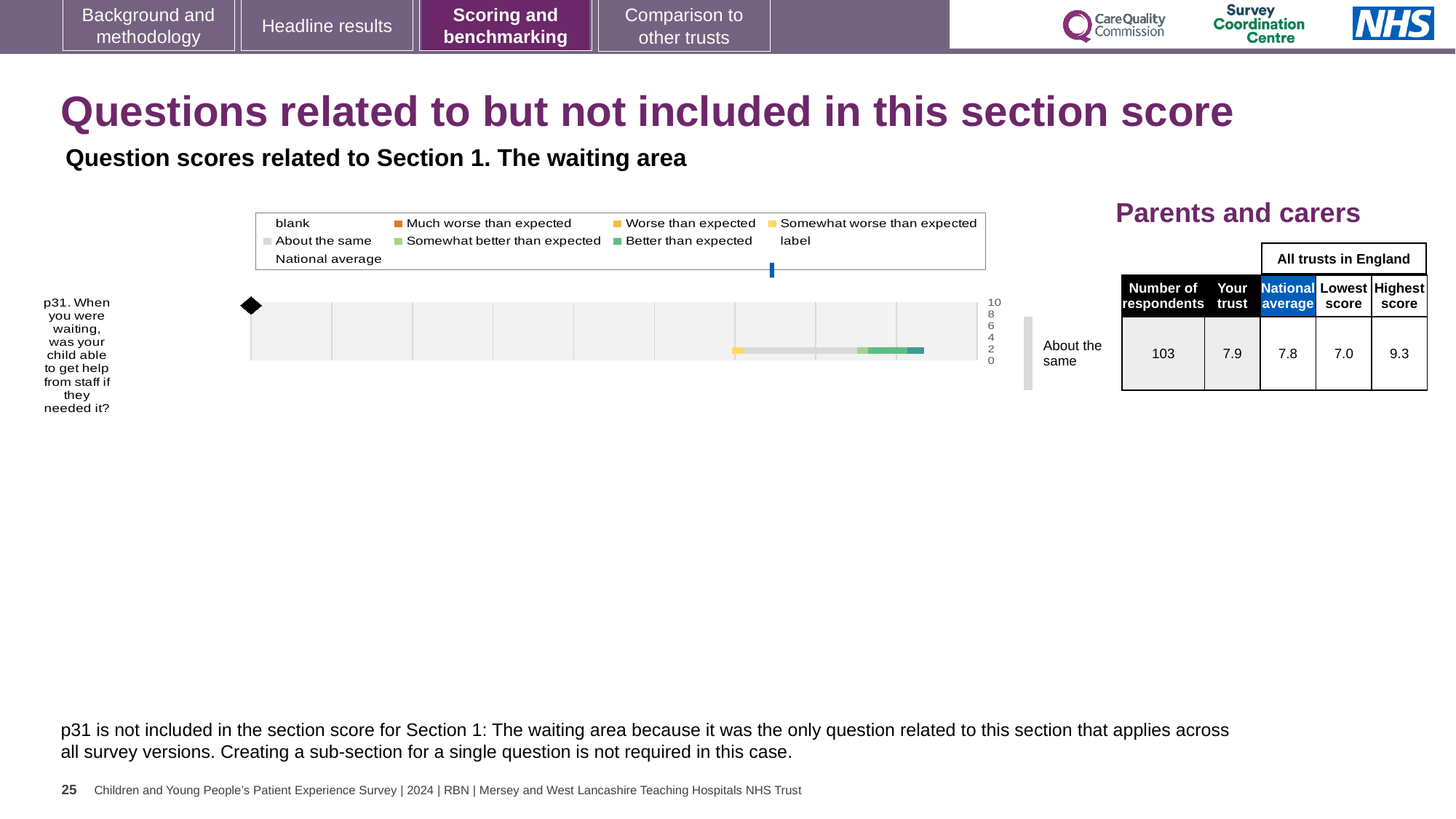
Which is larger for p31: the 'Your trust' score or the National average? Your trust How many entries does the chart legend list? 9 Which question is plotted in the chart? p31. When you were waiting, was your child able to get help from staff if they needed it? What rating label is shown next to the bar for p31? About the same In the table beside the chart, what is the Lowest score among all trusts in England for p31? 7.0 In the table beside the chart, what is the Highest score among all trusts in England for p31? 9.3 In the table beside the chart, how many respondents answered p31? 103 In the table beside the chart, what is the National average score for p31? 7.8 What is the highest tick value shown on the chart's axis? 10 What kind of chart is shown on the slide? bar chart How many questions (categories) are plotted in the chart? 1 In the table beside the chart, what is the 'Your trust' score for p31? 7.9